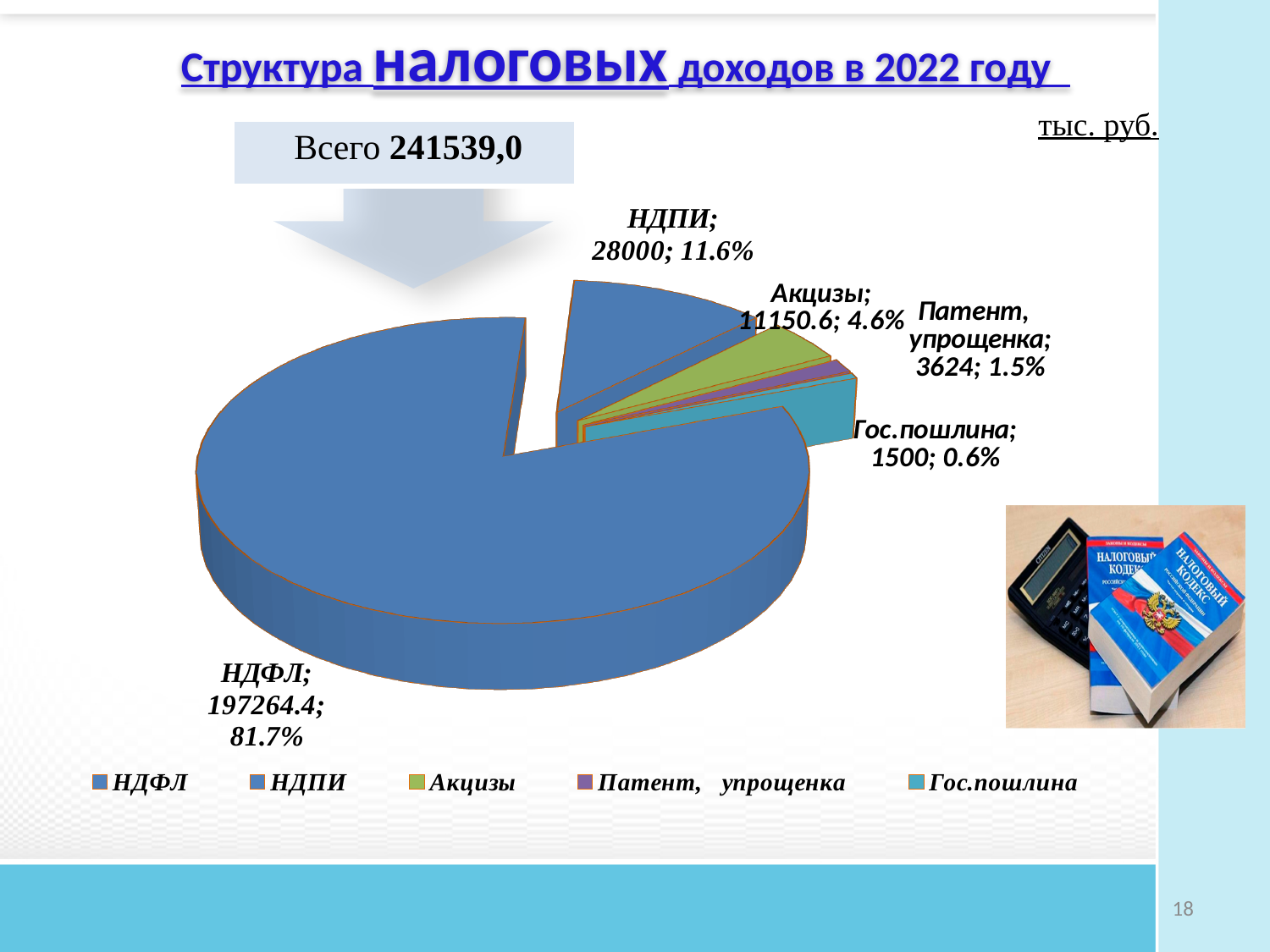
Which category has the smallest slice? Гос.пошлина What is the value for НДФЛ? 197264.4 Which category has the largest slice? НДФЛ What is the difference between the values for НДПИ and Акцизы? 16849.4 What kind of chart is shown on the slide? pie chart What is the value for НДПИ? 28000 Which is larger, the value for Акцизы or the value for Патент, упрощенка? Акцизы What is the value for Акцизы? 11150.6 What share of the pie does НДФЛ represent? 81.7% How many categories does the legend list? 5 What is the value for Гос.пошлина? 1500 What share of the pie does Патент, упрощенка represent? 1.5%